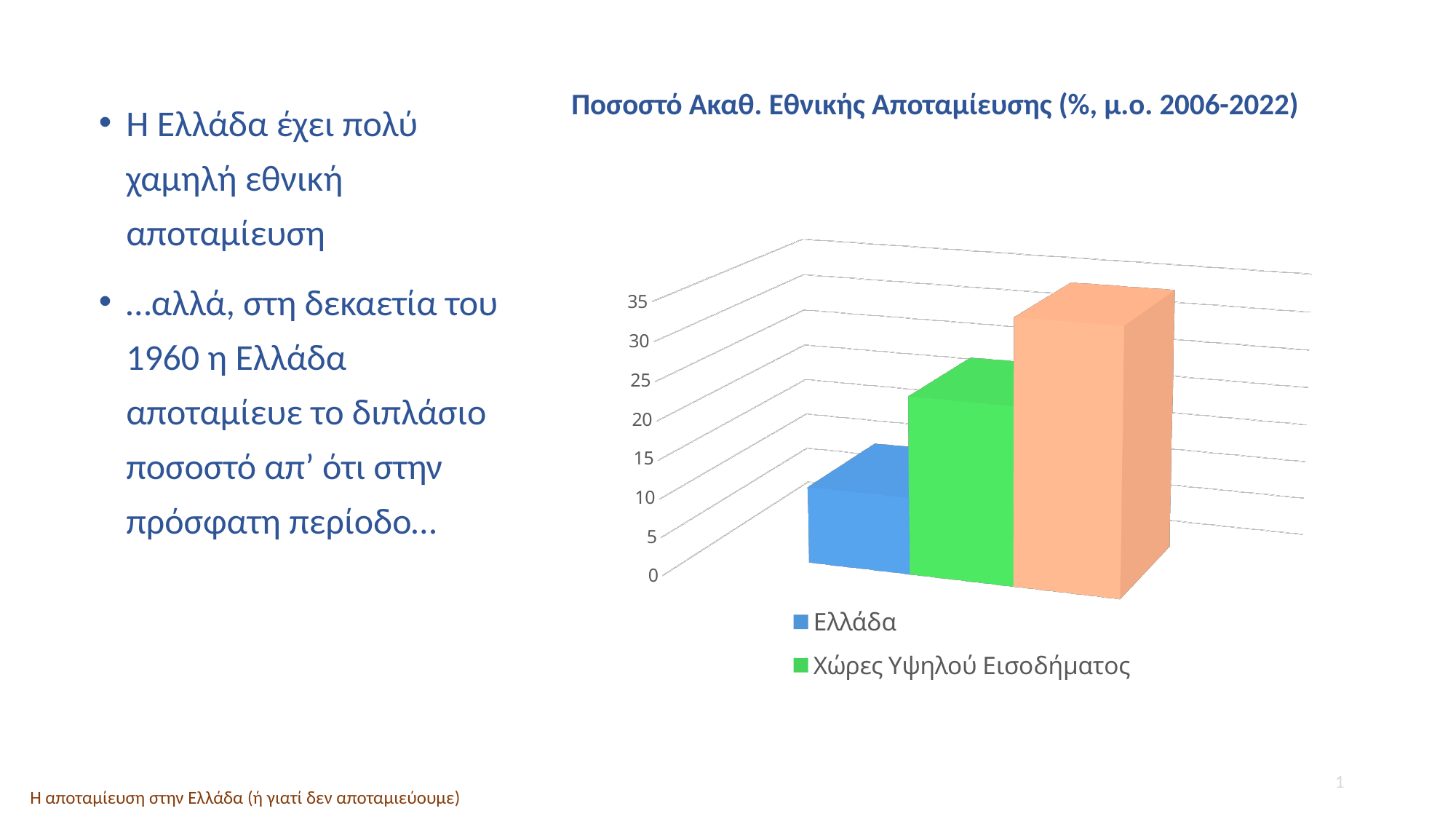
Which is larger, the value for Ελλάδα or the value for Χώρες Υψηλού Εισοδήματος? Χώρες Υψηλού Εισοδήματος What is the highest value shown on the vertical axis? 35 Is the value for Ελλάδα greater or less than 5? greater What is the title of the chart? Ποσοστό Ακαθ. Εθνικής Αποταμίευσης (%, μ.ο. 2006-2022) Is the value for Ελλάδα greater or less than 20? less What kind of chart is shown on the slide? bar chart What colour is the bar for Ελλάδα? blue How many bars are plotted in the chart? 3 Which of the two legend entries, Ελλάδα or Χώρες Υψηλού Εισοδήματος, has the lower value? Ελλάδα How many series does the chart legend list? 2 Is the value for Χώρες Υψηλού Εισοδήματος greater or less than 15? greater